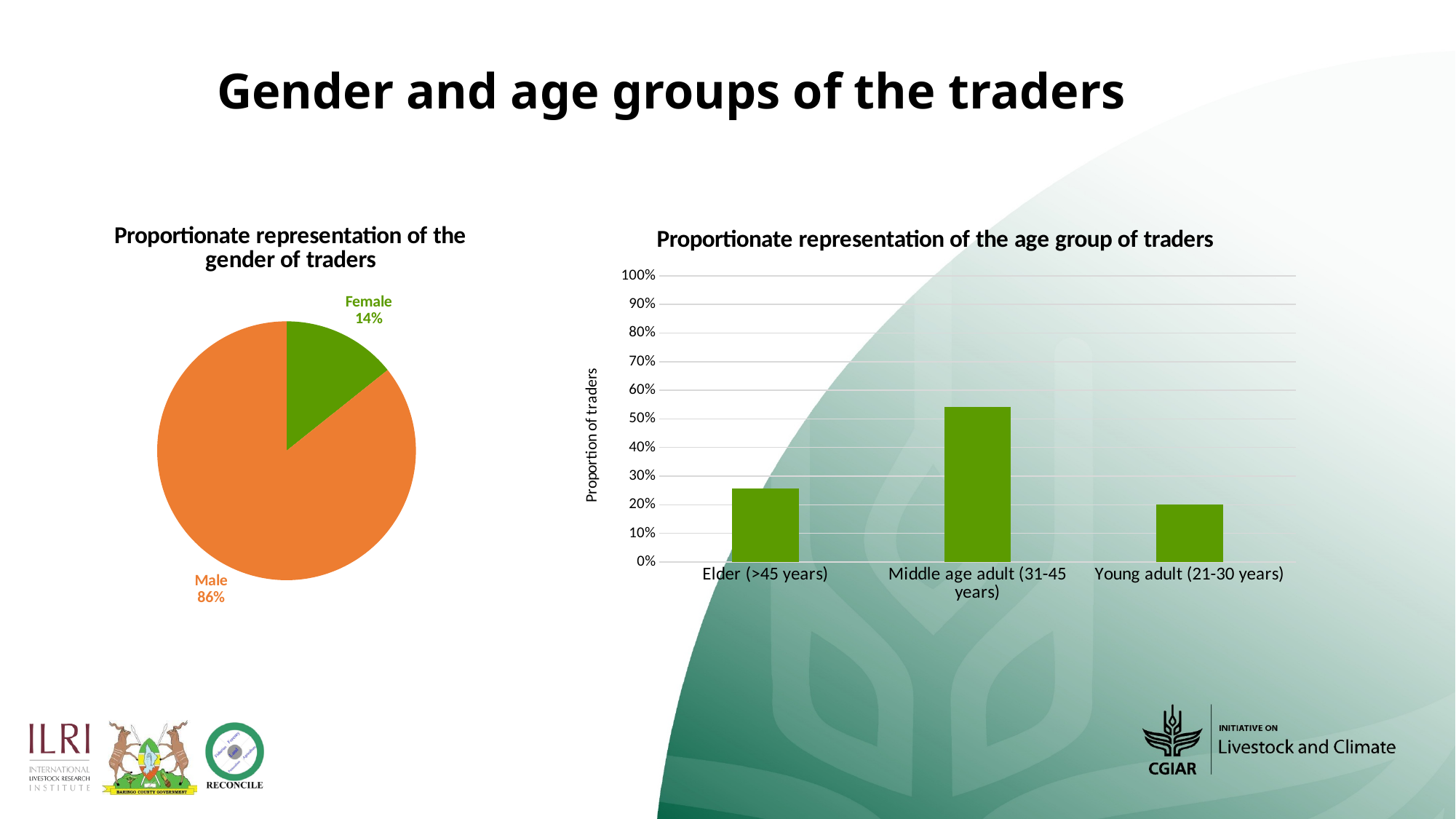
In the 'Proportionate representation of the age group of traders' chart, what is the label of the vertical axis? Proportion of traders In the 'Proportionate representation of the gender of traders' chart, what percentage of traders are male? 86% What kind of chart is the 'Proportionate representation of the age group of traders' chart? Bar chart In the 'Proportionate representation of the gender of traders' chart, what percentage of traders are female? 14% In the 'Proportionate representation of the age group of traders' chart, which age group has the lowest proportion of traders? Young adult (21-30 years) In the 'Proportionate representation of the age group of traders' chart, which age group has the highest proportion of traders? Middle age adult (31-45 years) In the 'Proportionate representation of the gender of traders' chart, what is the difference in percentage points between the male and female shares? 72 In the 'Proportionate representation of the gender of traders' chart, which gender has the larger share? Male In the 'Proportionate representation of the age group of traders' chart, is the value for Elder (>45 years) greater or less than 30%? less In the 'Proportionate representation of the age group of traders' chart, how many age groups are shown? 3 What kind of chart is the 'Proportionate representation of the gender of traders' chart? Pie chart In the 'Proportionate representation of the age group of traders' chart, is the value for Middle age adult (31-45 years) greater or less than 50%? greater